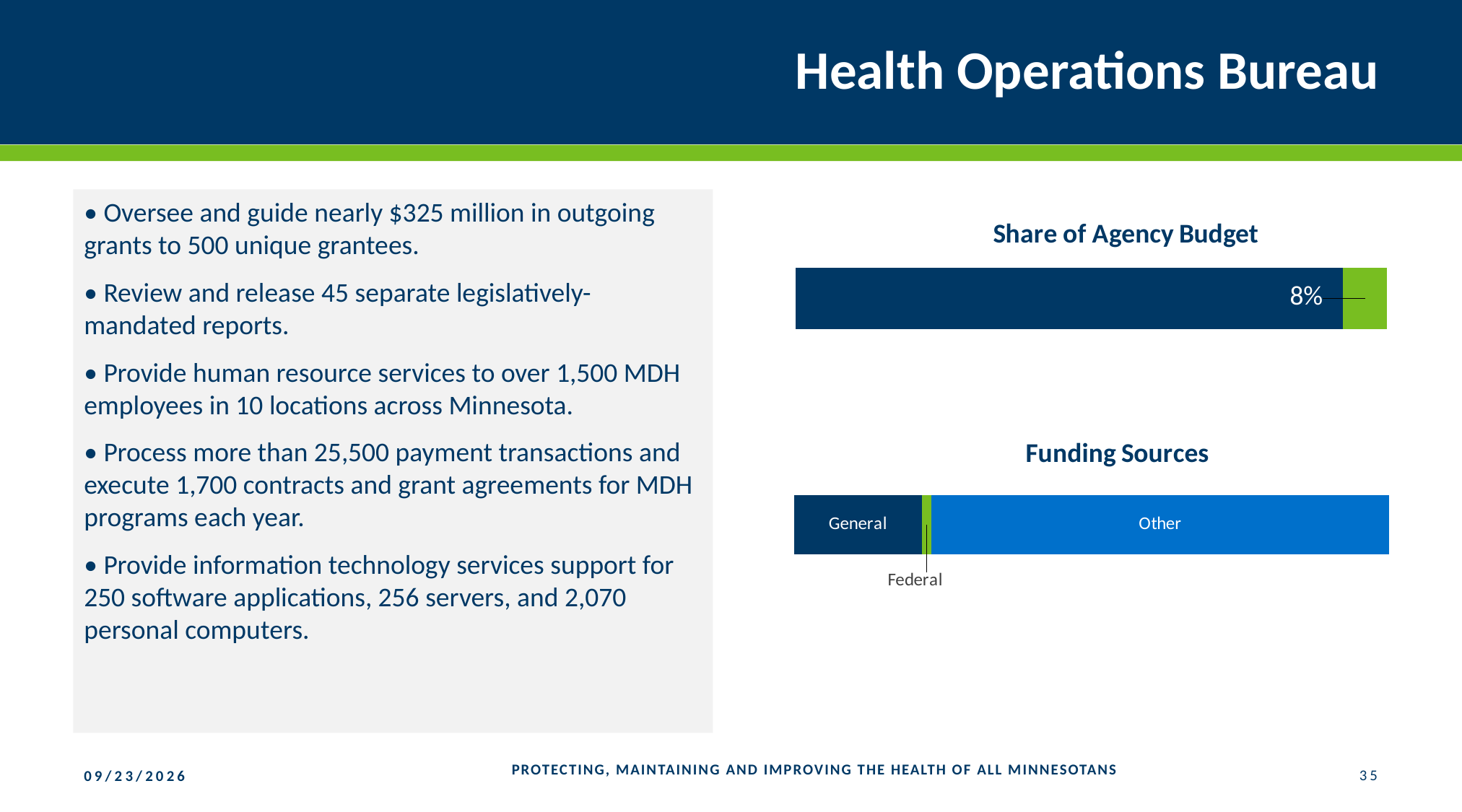
In the Funding Sources chart, which is larger, General or Federal? General In the Share of Agency Budget chart, what percentage is printed as the bureau's share of the agency budget? 8% In the Funding Sources chart, which is larger, General or Other? Other In the Funding Sources chart, which funding source is the smallest? Federal What kind of chart is the Funding Sources chart? bar chart In the Funding Sources chart, which funding source is the largest? Other What is the title of the upper chart on the slide? Share of Agency Budget In the Funding Sources chart, what are the three funding sources labeled? General, Federal, Other In the Funding Sources chart, how many funding source segments are shown? 3 In the Share of Agency Budget chart, is the bureau's share greater or less than 50%? less What kind of chart is the Share of Agency Budget chart? bar chart